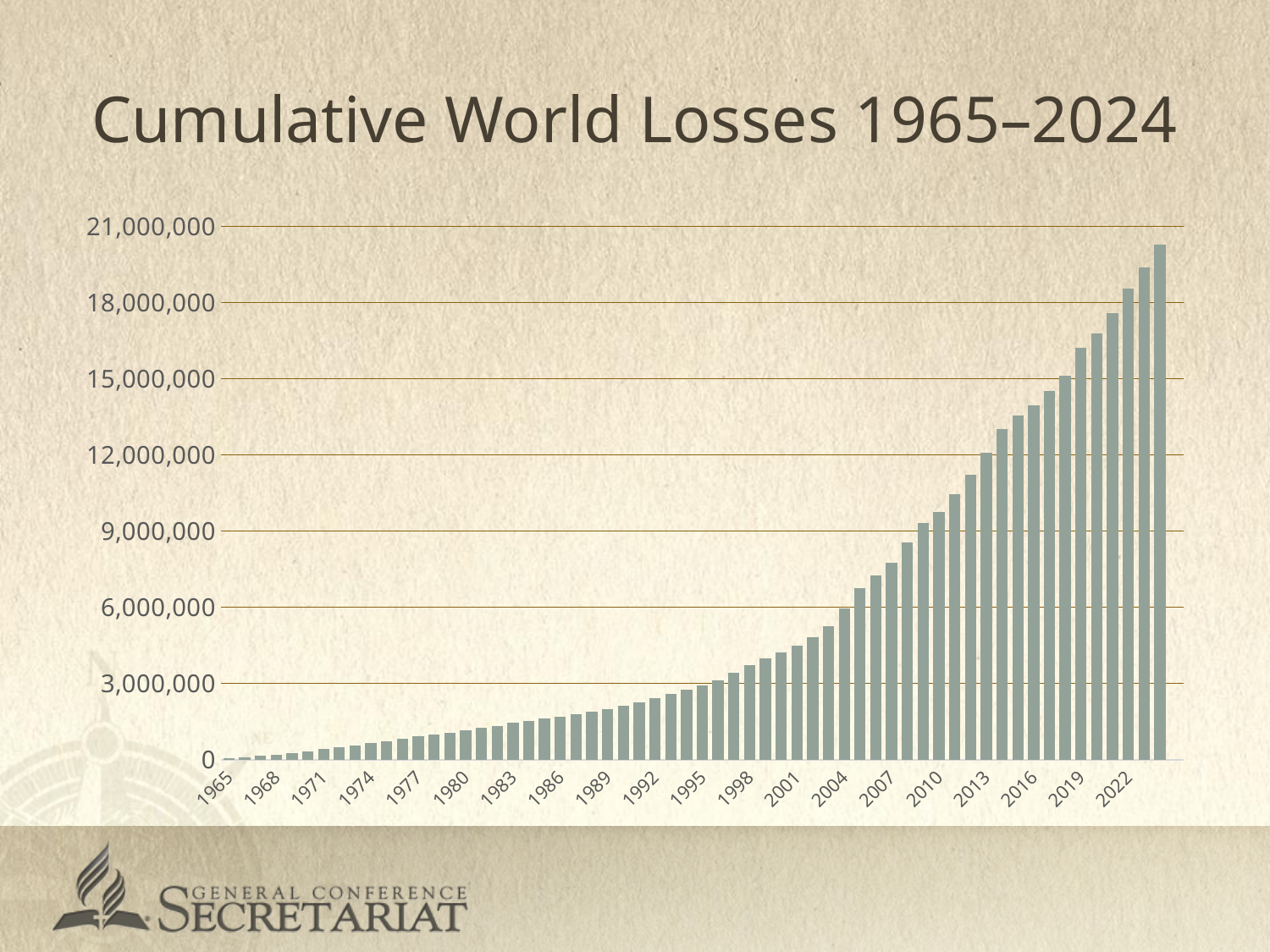
Which year has the highest cumulative world losses? 2024 Which year has the lowest cumulative world losses? 1965 Is the value for 2016 greater or less than 15,000,000? less What is the highest value shown on the y axis? 21,000,000 What is the title of the chart? Cumulative World Losses 1965–2024 Do the values rise or fall from 1965 to 2024 along the x axis? rise What kind of chart is shown on the slide? bar chart Which is larger, the value for 2022 or the value for 2013? 2022 Is the value for 2022 greater or less than 18,000,000? greater Is the value for 2010 greater or less than 9,000,000? greater